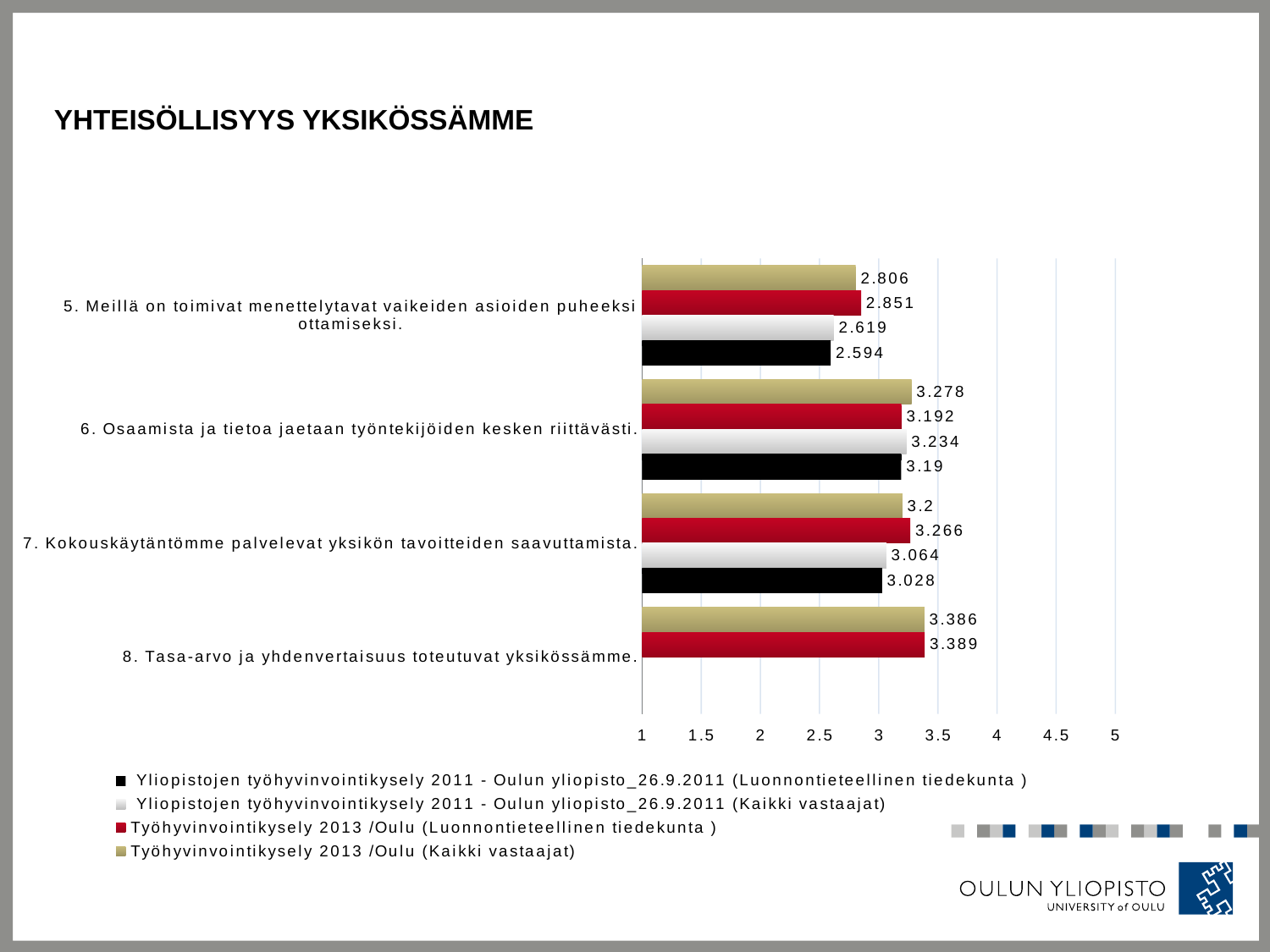
How many series does the legend list? 4 Which item has the highest value for the "Työhyvinvointikysely 2013 /Oulu (Luonnontieteellinen tiedekunta)" series? 8. Tasa-arvo ja yhdenvertaisuus toteutuvat yksikössämme. What is the difference between the 2013 Luonnontieteellinen tiedekunta value (2.851) and the 2011 Luonnontieteellinen tiedekunta value (2.594) on item 5? 0.257 What is the value for "Yliopistojen työhyvinvointikysely 2011 - Oulun yliopisto_26.9.2011 (Luonnontieteellinen tiedekunta)" on item 6 (Osaamista ja tietoa jaetaan työntekijöiden kesken riittävästi)? 3.19 What is the value for "Työhyvinvointikysely 2013 /Oulu (Kaikki vastaajat)" on item 8 (Tasa-arvo ja yhdenvertaisuus toteutuvat yksikössämme)? 3.386 What is the value for "Työhyvinvointikysely 2013 /Oulu (Kaikki vastaajat)" on item 5 (Meillä on toimivat menettelytavat vaikeiden asioiden puheeksi ottamiseksi)? 2.806 What kind of chart is shown on the slide? Bar chart Is the value for "Yliopistojen työhyvinvointikysely 2011 - Oulun yliopisto_26.9.2011 (Luonnontieteellinen tiedekunta)" on item 5 greater or less than 3? less Which item has the lowest value for the "Yliopistojen työhyvinvointikysely 2011 - Oulun yliopisto_26.9.2011 (Kaikki vastaajat)" series? 5. Meillä on toimivat menettelytavat vaikeiden asioiden puheeksi ottamiseksi. How many items (categories) are shown on the chart? 4 On item 7, which is larger: the "Työhyvinvointikysely 2013 /Oulu (Kaikki vastaajat)" value or the "Yliopistojen työhyvinvointikysely 2011 - Oulun yliopisto_26.9.2011 (Kaikki vastaajat)" value? Työhyvinvointikysely 2013 /Oulu (Kaikki vastaajat) What is the value for "Työhyvinvointikysely 2013 /Oulu (Luonnontieteellinen tiedekunta)" on item 7 (Kokouskäytäntömme palvelevat yksikön tavoitteiden saavuttamista)? 3.266